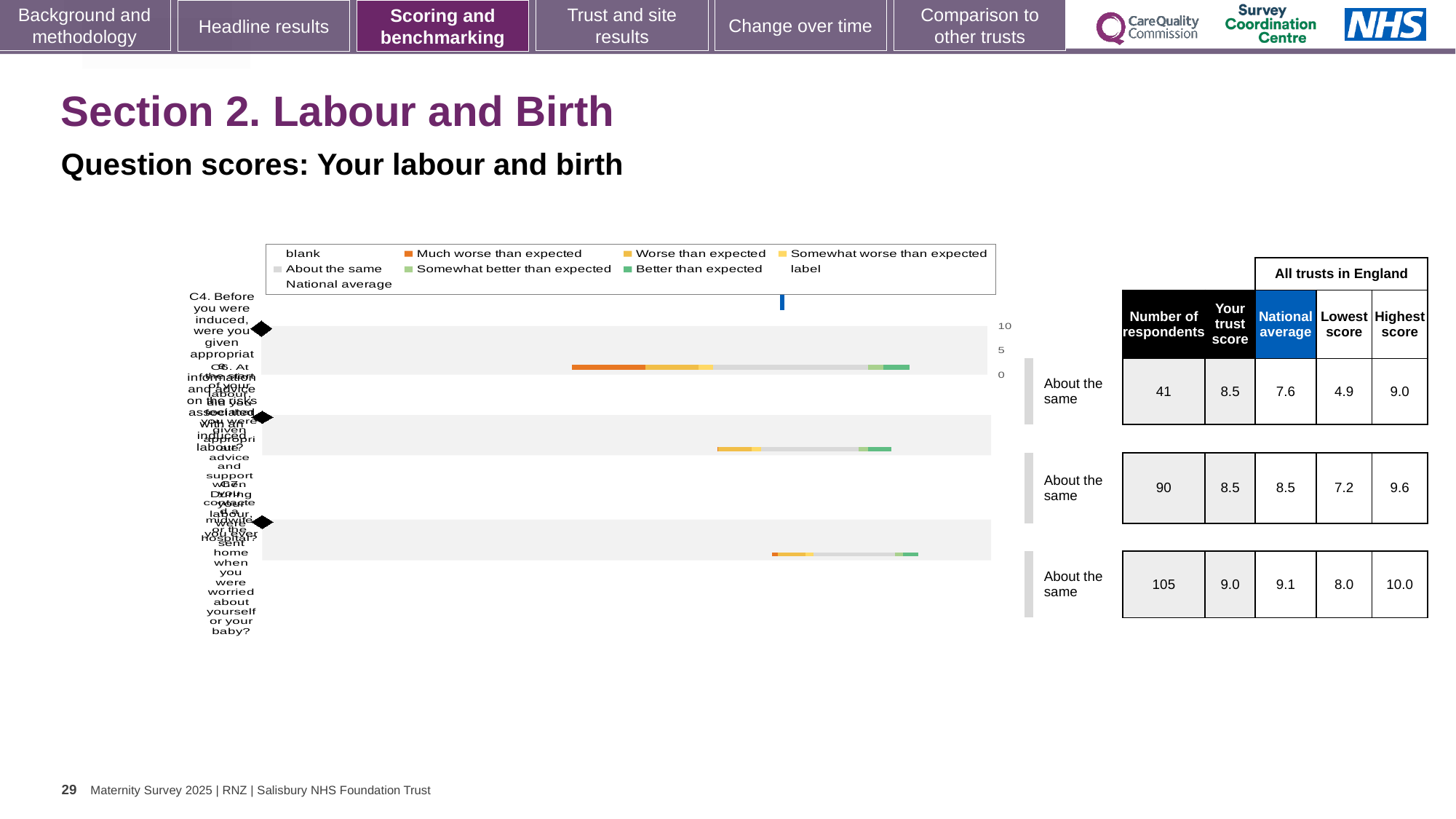
What kind of chart is shown on the slide? bar chart What benchmark category is shown for all three rows next to the chart? About the same In the table to the right of the chart, what is the highest score for the third row? 10.0 In the table to the right of the chart, what is the difference between the trust score and the national average in the first row? 0.9 In the table to the right of the chart, what is the lowest score for the first row? 4.9 How many question rows (bars) are plotted in the chart? 3 In the table to the right of the chart, what is the national average for the row with 105 respondents? 9.1 In the table to the right of the chart, which row has the highest number of respondents? the third row (105) In the table to the right of the chart, is the trust score for the first row larger or smaller than its national average? larger In the table to the right of the chart, what is the trust score for the row with 90 respondents? 8.5 In the table to the right of the chart, what is the number of respondents for the first row? 41 In the chart legend, what colour represents 'Much worse than expected'? orange